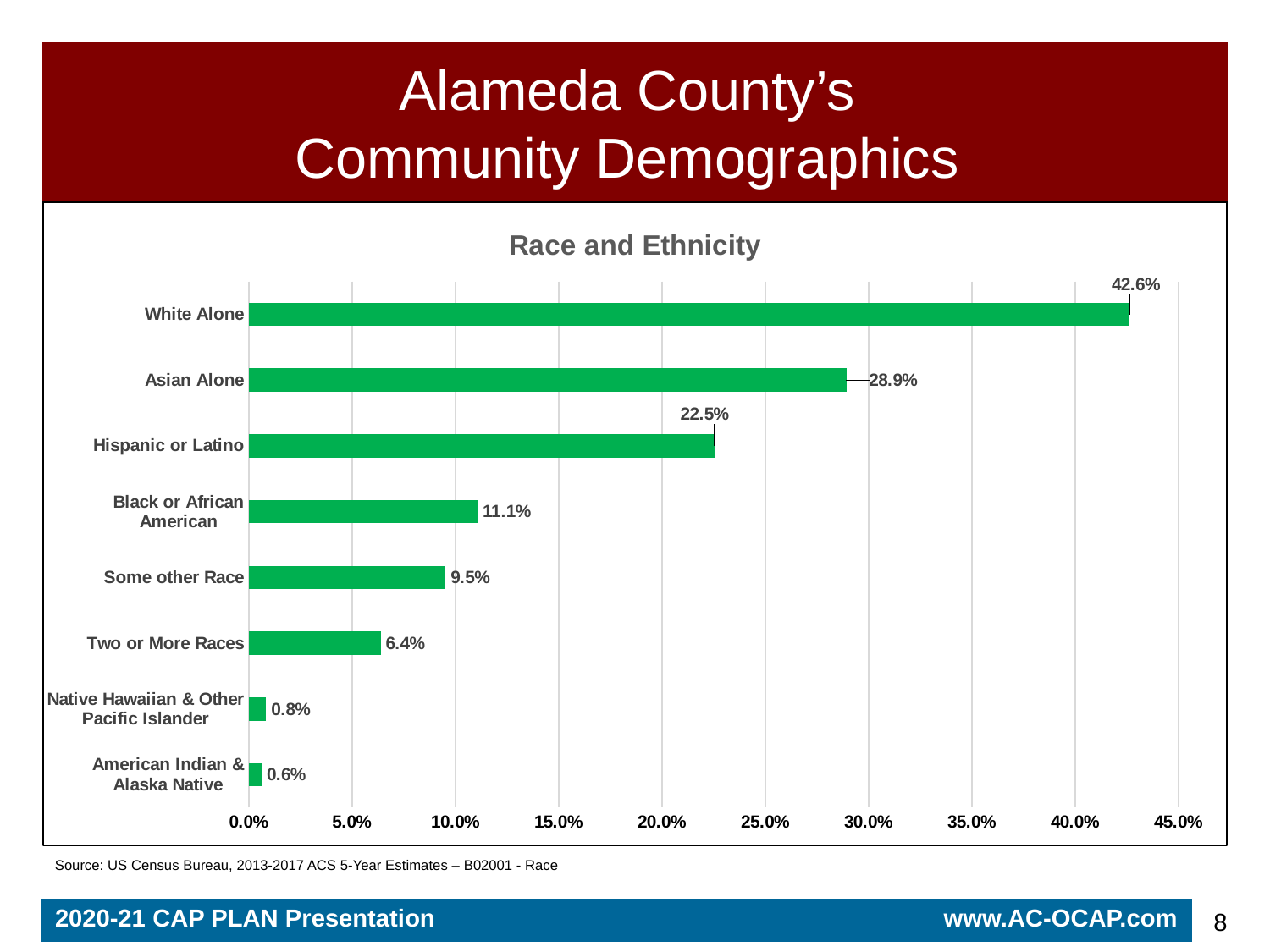
How many categories are shown in the chart? 8 What is the value for White Alone? 42.6% What is the value for Native Hawaiian & Other Pacific Islander? 0.8% Which category has the highest value? White Alone What is the difference between the values for White Alone and Asian Alone? 13.7% Is the value for Two or More Races greater or less than 10.0%? less What kind of chart is shown on the slide? bar chart Which category has the lowest value? American Indian & Alaska Native What is the value for Hispanic or Latino? 22.5% What is the difference between the values for Black or African American and Some other Race? 1.6% What is the title of the chart? Race and Ethnicity Which is larger, the value for Hispanic or Latino or the value for Asian Alone? Asian Alone